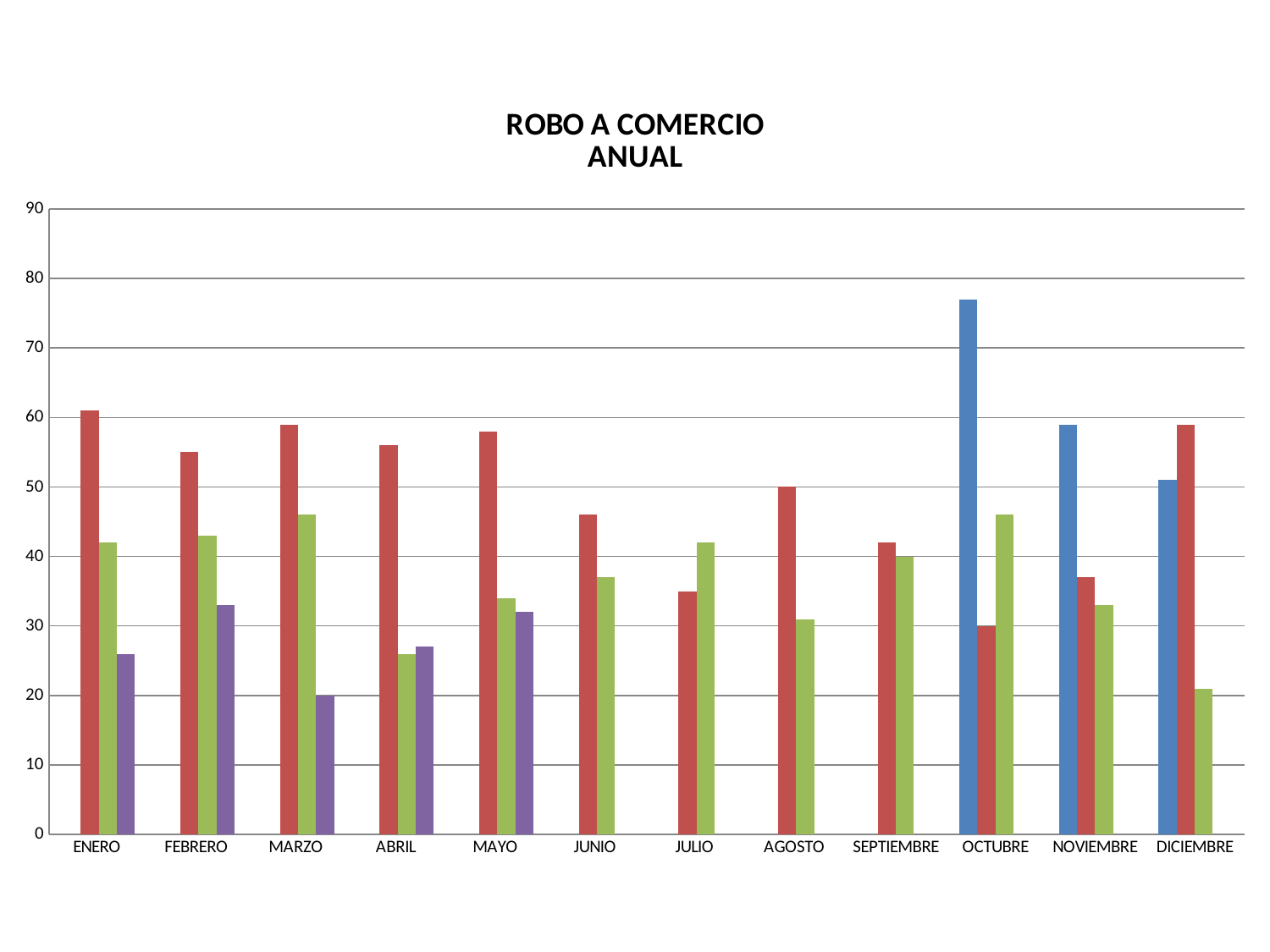
Which month has the lowest red bar? OCTUBRE In DICIEMBRE, which bar is taller, the blue one or the red one? red How many months are shown along the x axis? 12 What is the title of the chart? ROBO A COMERCIO ANUAL What kind of chart is shown on the slide? bar chart How many months have a purple bar? 5 Is the red bar for SEPTIEMBRE greater or less than 50? less Which month has the tallest bar in the chart? OCTUBRE Is the blue bar for OCTUBRE greater or less than 70? greater How many months have a blue bar? 3 Is the green bar for DICIEMBRE greater or less than 30? less In JULIO, which bar is taller, the red one or the green one? green